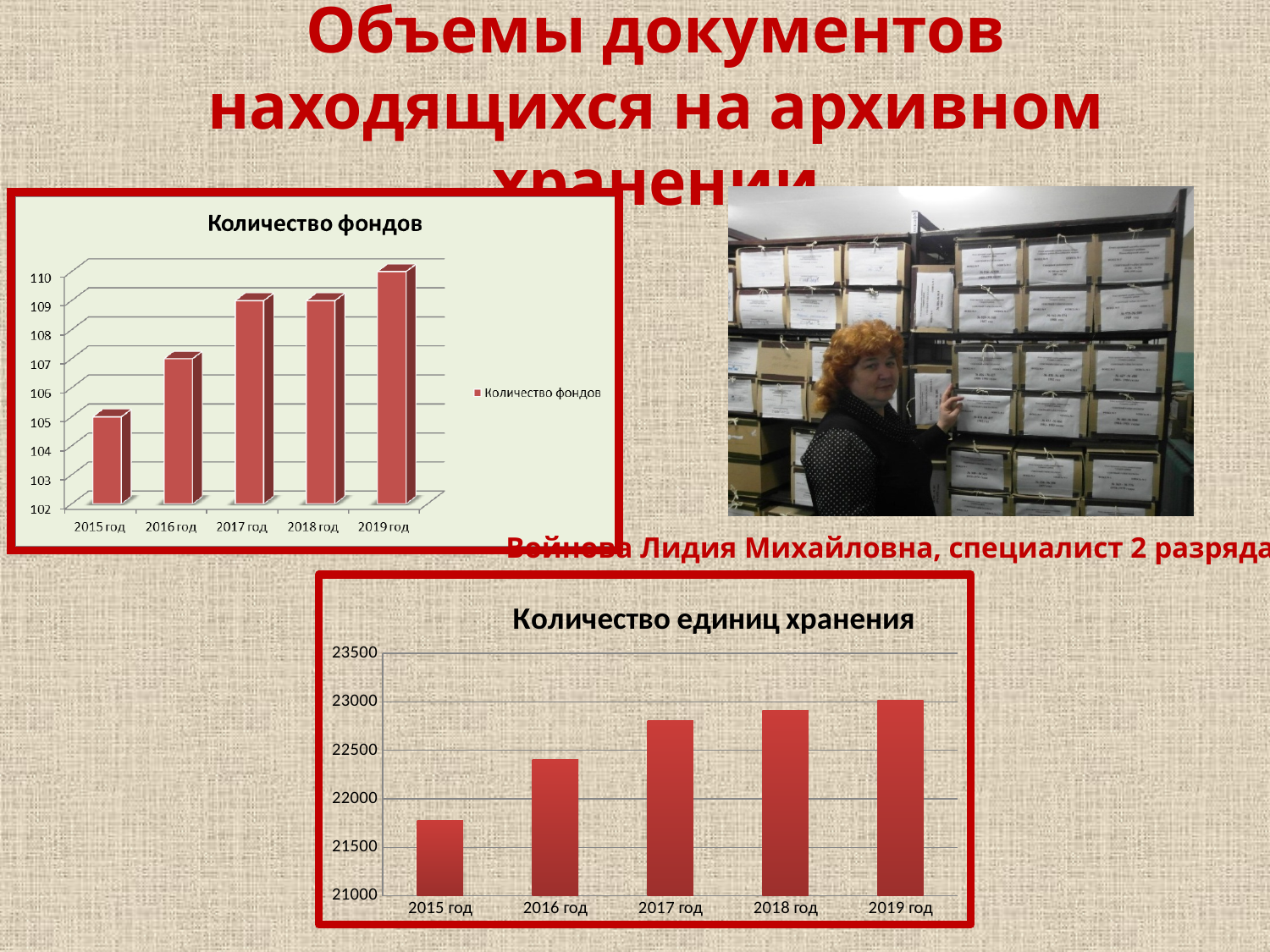
In the 'Количество фондов' chart, is the value for 2015 год greater or less than 106? less How many bars are in the 'Количество единиц хранения' chart? 5 In the 'Количество фондов' chart, is the value for 2016 год greater or less than 106? greater How many series does the legend of the 'Количество фондов' chart list? 1 In the 'Количество фондов' chart, which year has the highest value? 2019 год What kind of chart is the 'Количество единиц хранения' chart? bar chart In the 'Количество единиц хранения' chart, is the value for 2017 год greater or less than 22500? greater In the 'Количество фондов' chart, which year has the lowest value? 2015 год How many years are shown on the x axis of the 'Количество фондов' chart? 5 In the 'Количество единиц хранения' chart, which year has the lowest value? 2015 год What kind of chart is the 'Количество фондов' chart? bar chart